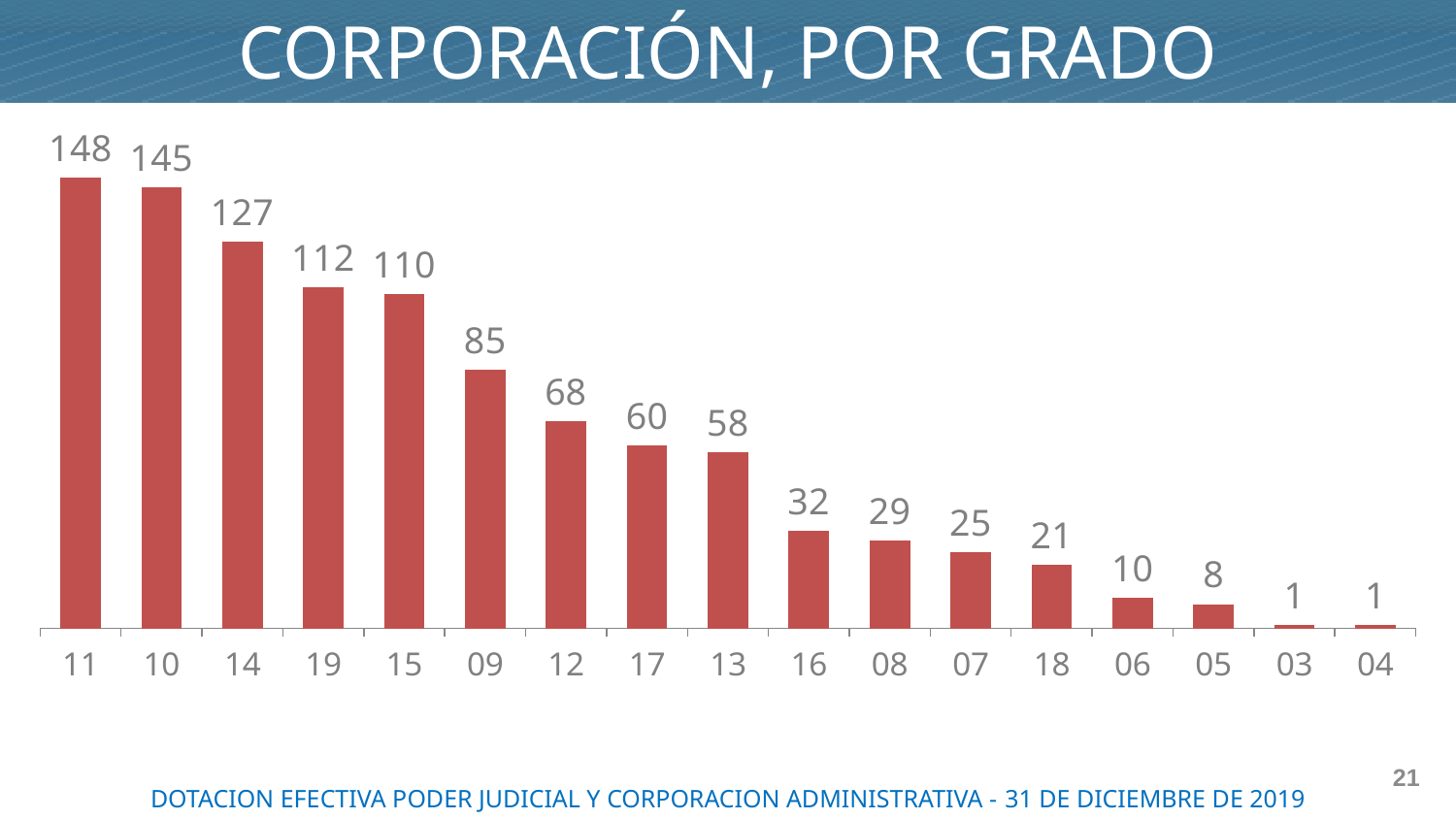
What colour are the bars? Red What kind of chart is this? Bar chart What is the value for grade 11? 148 Which grade has the highest value? 11 Which has a larger value, grade 12 or grade 13? 12 What is the value for grade 09? 85 What is the title of the chart? CORPORACIÓN, POR GRADO What is the value for grade 18? 21 What is the difference between the values for grade 14 and grade 19? 15 Do the values rise or fall from left to right along the x axis? Fall How many grades are shown on the x axis? 17 What is the difference between the values for grade 11 and grade 10? 3